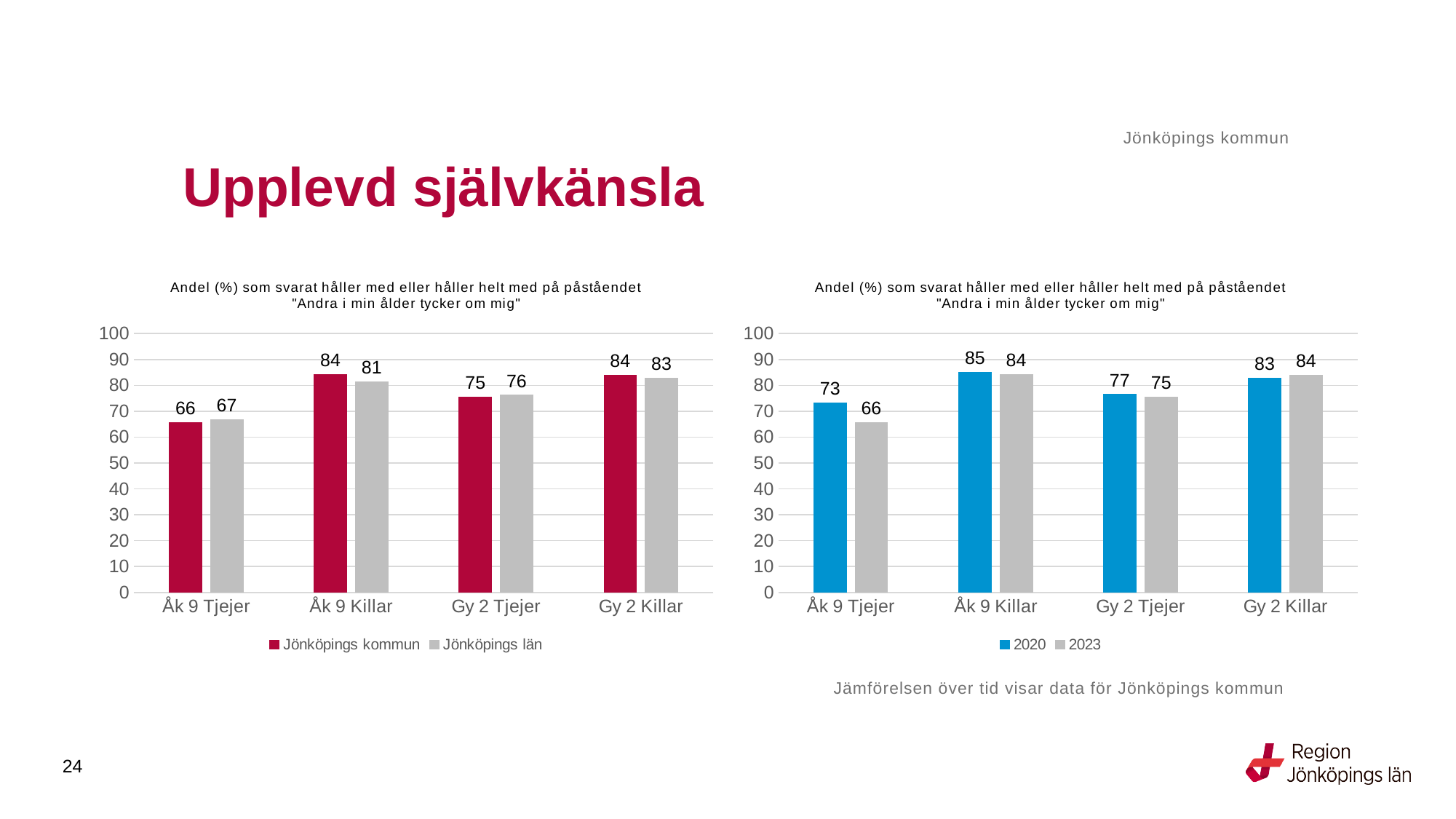
In the right chart, what is the 2023 value for Åk 9 Tjejer? 66 In the right chart, what is the difference between the 2020 and 2023 values for Åk 9 Tjejer? 7 In the left chart, which is larger for Gy 2 Tjejer: Jönköpings kommun or Jönköpings län? Jönköpings län How many categories are shown on the x axis of the right chart? 4 What kind of chart is the right chart? Bar chart In the right chart, what is the 2020 value for Gy 2 Tjejer? 77 In the left chart, what is the value for Jönköpings kommun for Åk 9 Tjejer? 66 How many series does the legend of the left chart list? 2 In the left chart, what is the difference between Jönköpings kommun and Jönköpings län for Åk 9 Killar? 3 In the left chart, what is the value for Jönköpings län for Åk 9 Killar? 81 In the right chart, which category has the highest 2020 value? Åk 9 Killar In the left chart, which category has the lowest value for Jönköpings kommun? Åk 9 Tjejer